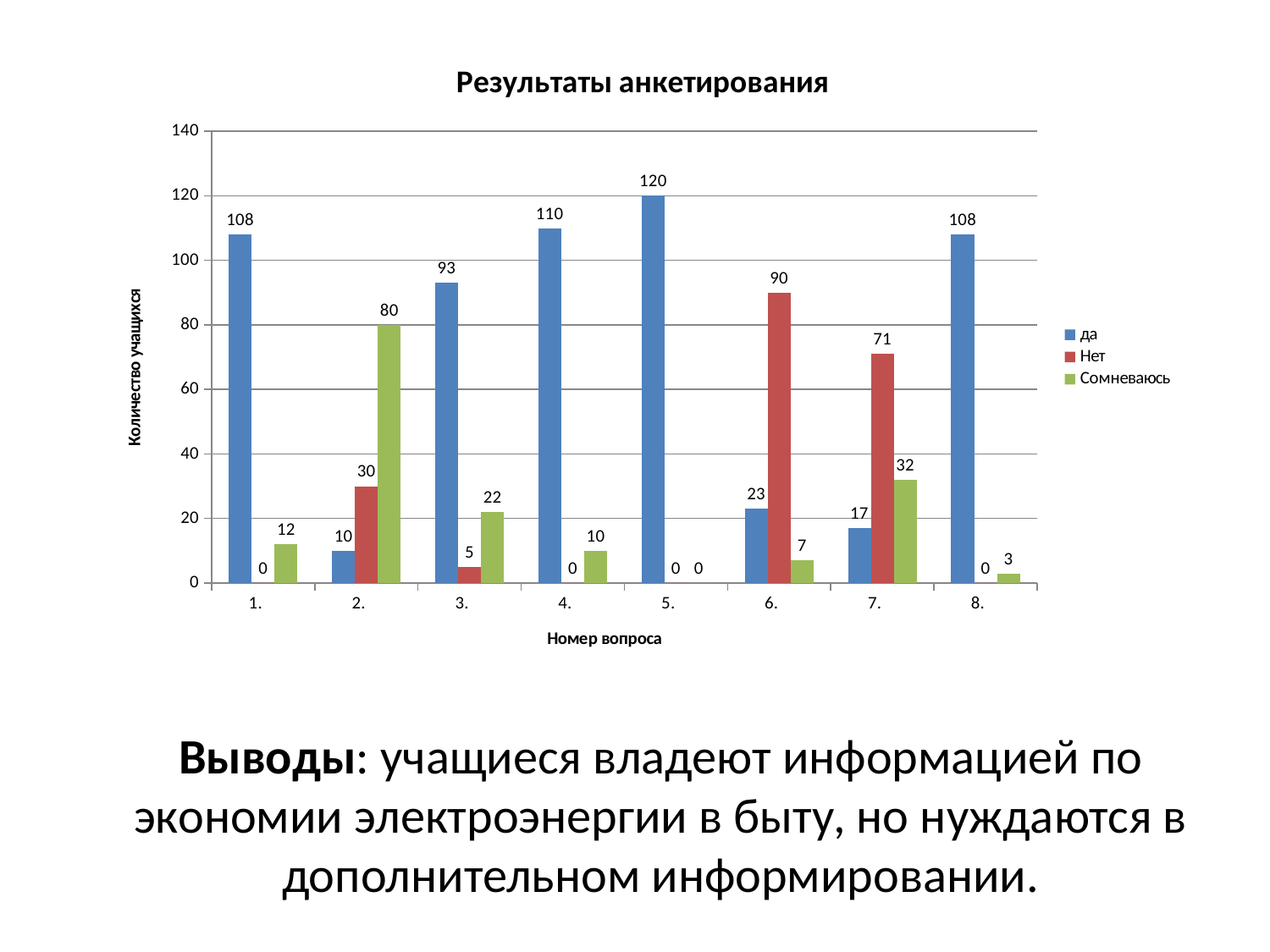
What is the value of the 'Сомневаюсь' series for question 2? 80 What kind of chart is shown on the slide? bar chart What is the total of the three series for question 6? 120 How many question numbers are shown on the x axis? 8 What is the title of the chart? Результаты анкетирования How many series does the legend list? 3 For which question number is the 'да' value highest? 5. For which question number is the 'да' value lowest? 2. What is the value of the 'Нет' series for question 6? 90 Which is larger for question 3: the 'да' value or the 'Сомневаюсь' value? да What is the difference between the 'Нет' value for question 7 and the 'Сомневаюсь' value for question 7? 39 What is the value of the 'да' series for question 5? 120